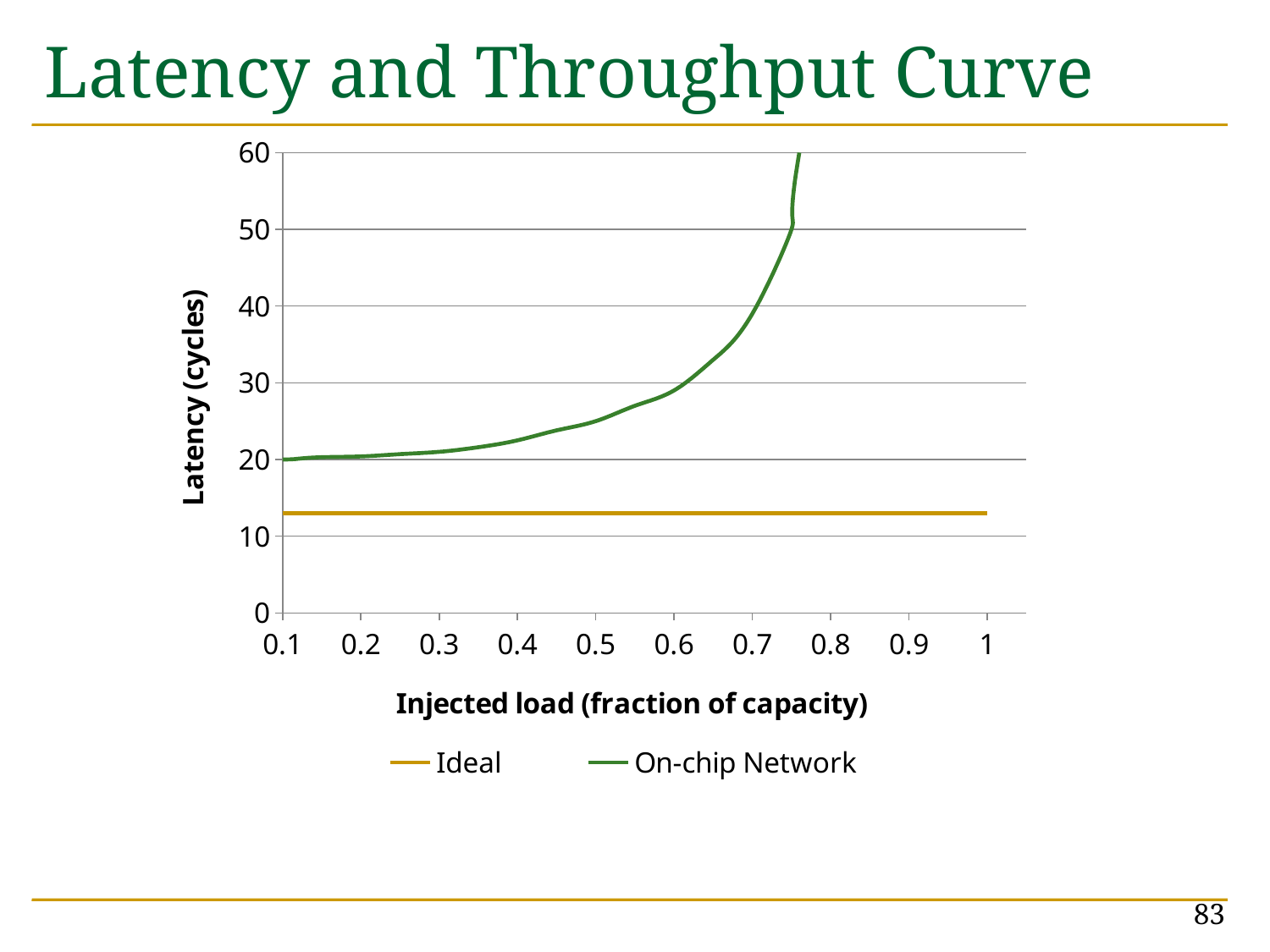
Is the On-chip Network latency at an injected load of 0.7 greater or less than 30 cycles? greater What are the names of the two series in the legend? Ideal and On-chip Network At an injected load of 0.6, which series has the higher latency, Ideal or On-chip Network? On-chip Network Is the Ideal latency greater or less than 20 cycles? less How many series does the legend list? 2 Is the On-chip Network latency at an injected load of 0.5 greater or less than 20 cycles? greater What kind of chart is shown on the slide? line chart What is the title of the chart? Latency and Throughput Curve How many injected load values are marked on the x axis? 10 Does the On-chip Network latency rise or fall as injected load increases? rise Does the Ideal latency rise, fall, or stay flat as injected load increases? stay flat